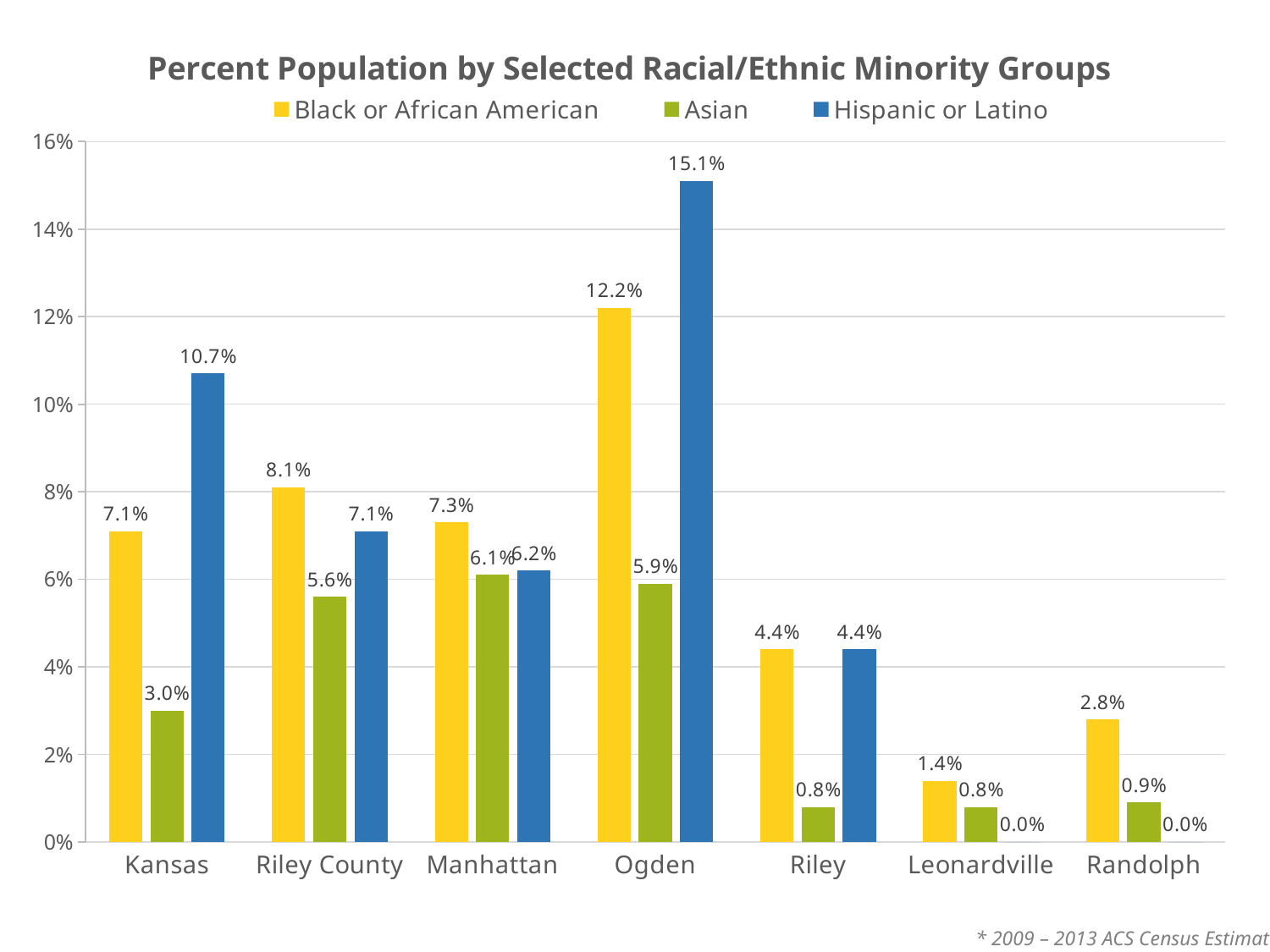
How many series does the legend list? 3 Is the Black or African American value for Ogden greater or less than 10%? greater How many categories are shown on the x axis? 7 What is the Black or African American percentage for Riley County? 8.1% What kind of chart is shown on the slide? Bar chart What is the Asian percentage for Kansas? 3.0% Which category has the lowest Black or African American percentage? Leonardville What is the Hispanic or Latino percentage for Ogden? 15.1% What is the title of the chart? Percent Population by Selected Racial/Ethnic Minority Groups Which is larger for Manhattan: the Black or African American percentage or the Asian percentage? Black or African American What is the difference between the Hispanic or Latino percentage for Kansas and for Riley County? 3.6% Which category has the highest Hispanic or Latino percentage? Ogden